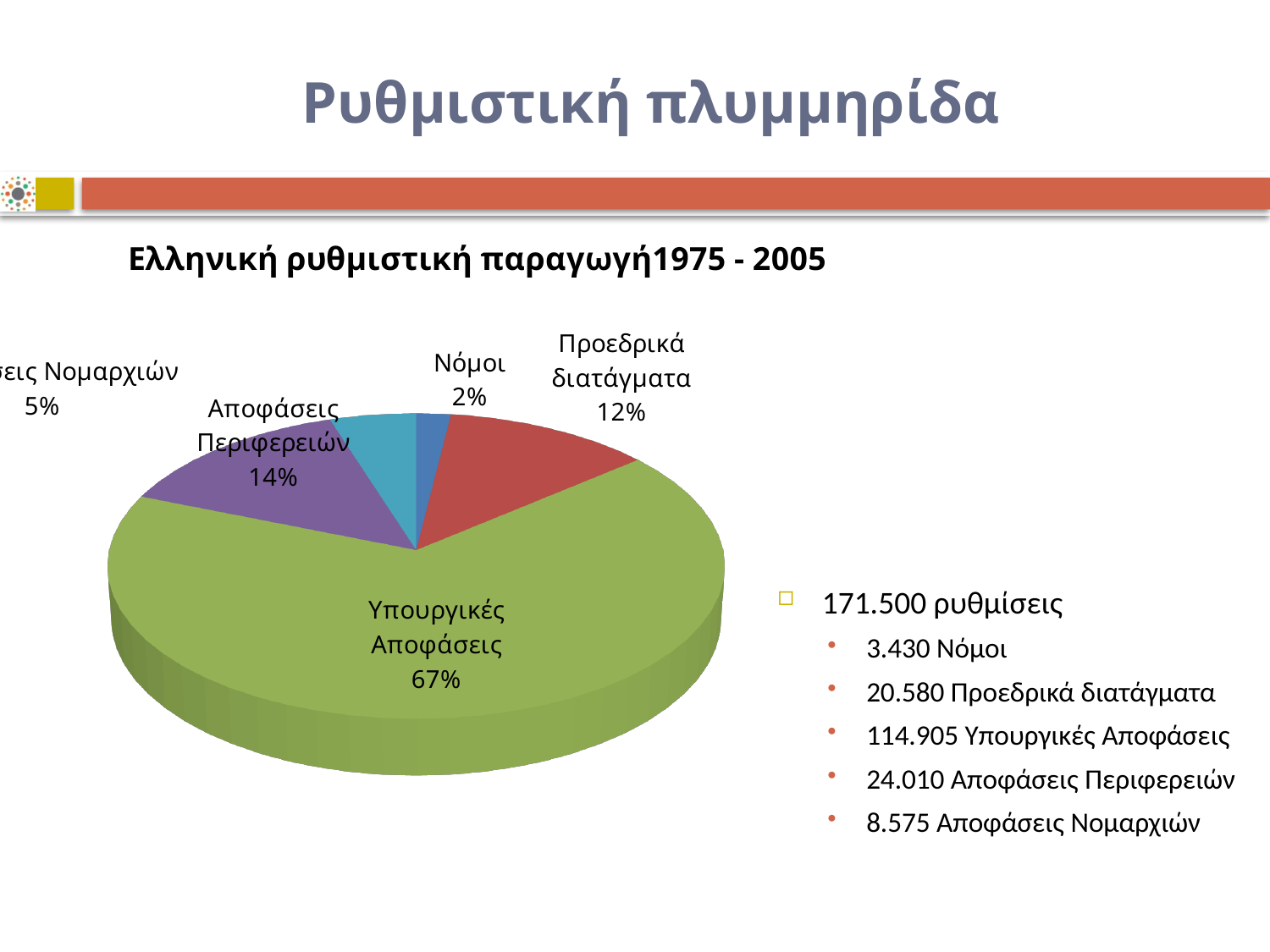
Which category has the smallest slice of the pie? Νόμοι What percentage is shown for Προεδρικά διατάγματα? 12% How many slices does the pie chart have? 5 What percentage is shown for Νόμοι? 2% What share of the pie does Υπουργικές Αποφάσεις represent? 67% What kind of chart is shown on the slide? pie chart Which category has the largest slice of the pie? Υπουργικές Αποφάσεις What is the difference in percentage points between Υπουργικές Αποφάσεις and Αποφάσεις Περιφερειών? 53 percentage points Which is larger, the slice for Προεδρικά διατάγματα or the slice for Αποφάσεις Περιφερειών? Αποφάσεις Περιφερειών What is the title of the chart? Ελληνική ρυθμιστική παραγωγή1975 - 2005 What percentage is shown for Αποφάσεις Περιφερειών? 14% What colour is the largest slice of the pie? green